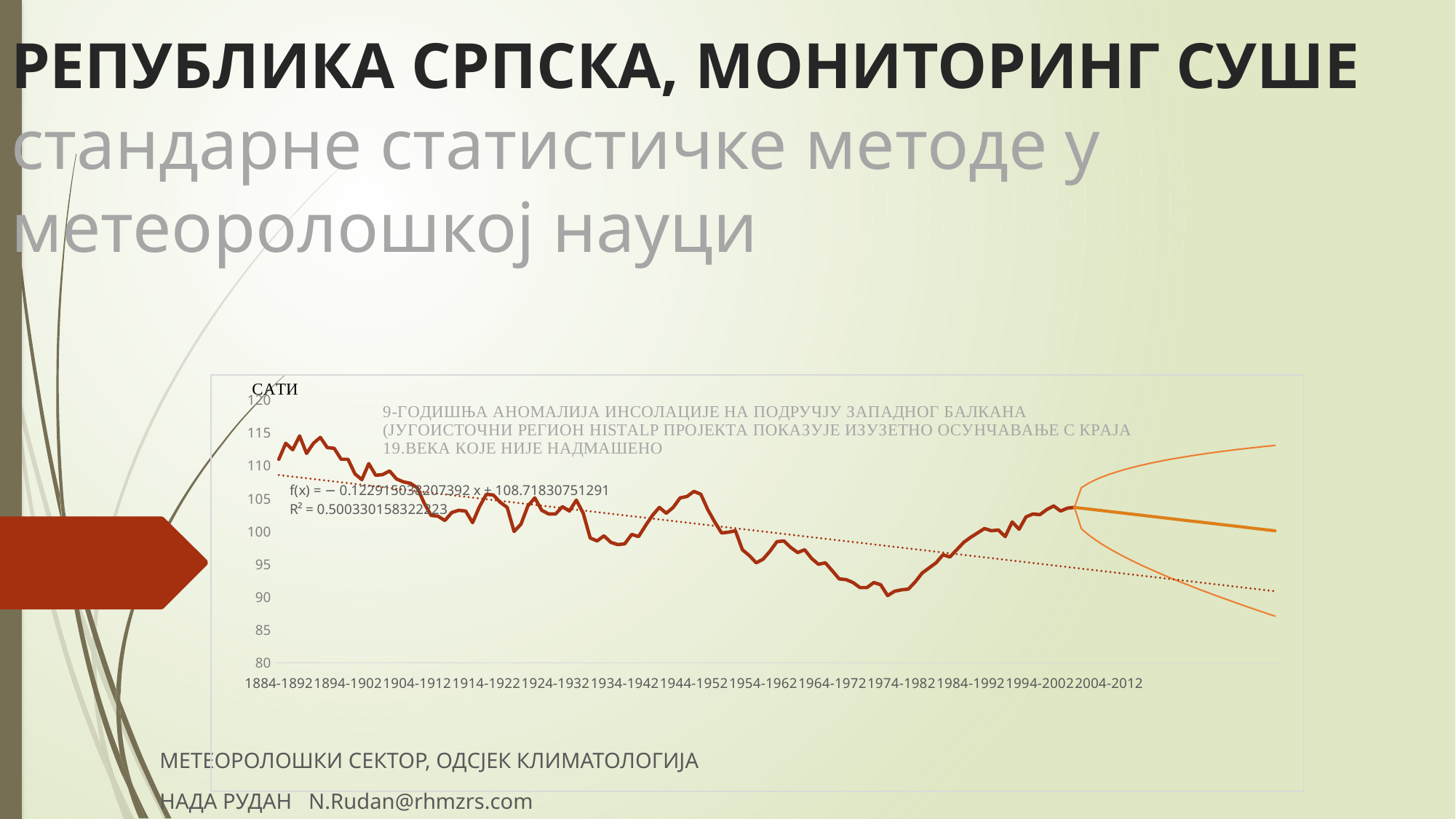
Which period on the x axis has the lowest plotted value? 1974-1982 Is the value for 1974-1982 greater or less than 95? less What label is shown on the vertical axis of the chart? САТИ What is the intercept term in the trend line equation printed on the chart? 108.71830751291 What R² value is printed on the chart for the trend line? R² = 0.500330158322223 Which is larger, the value for 1884-1892 or the value for 1974-1982? 1884-1892 How many period labels are shown on the x axis? 13 What kind of chart is shown on the slide? line chart Do the plotted values generally rise or fall along the x axis from 1884-1892 to 2004-2012? fall Is the value for 1884-1892 greater or less than 105? greater